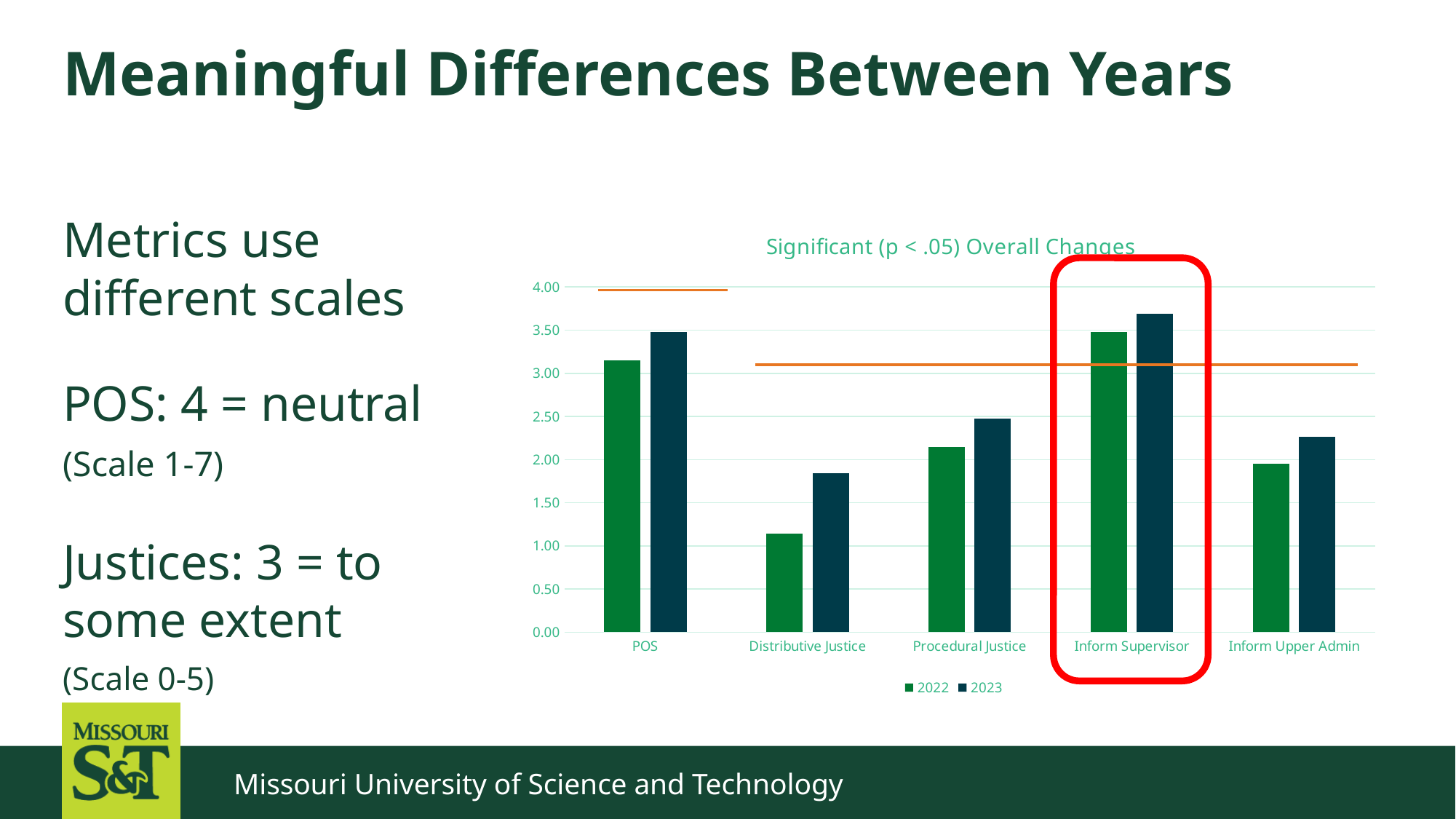
For Procedural Justice, which is larger: the 2022 value or the 2023 value? 2023 What is the title of the chart? Significant (p < .05) Overall Changes Which category has the lowest 2023 value? Distributive Justice Is the 2023 value for Inform Supervisor greater or less than 3.50? greater What kind of chart is shown on the slide? bar chart Which category is highlighted with a red outline on the chart? Inform Supervisor Is the 2022 value for POS greater or less than 3.00? greater Is the 2023 value for Distributive Justice greater or less than 2.00? less How many categories are shown on the x axis of the chart? 5 How many series does the chart legend list? 2 Which category has the highest 2023 value? Inform Supervisor Which category has the lowest 2022 value? Distributive Justice